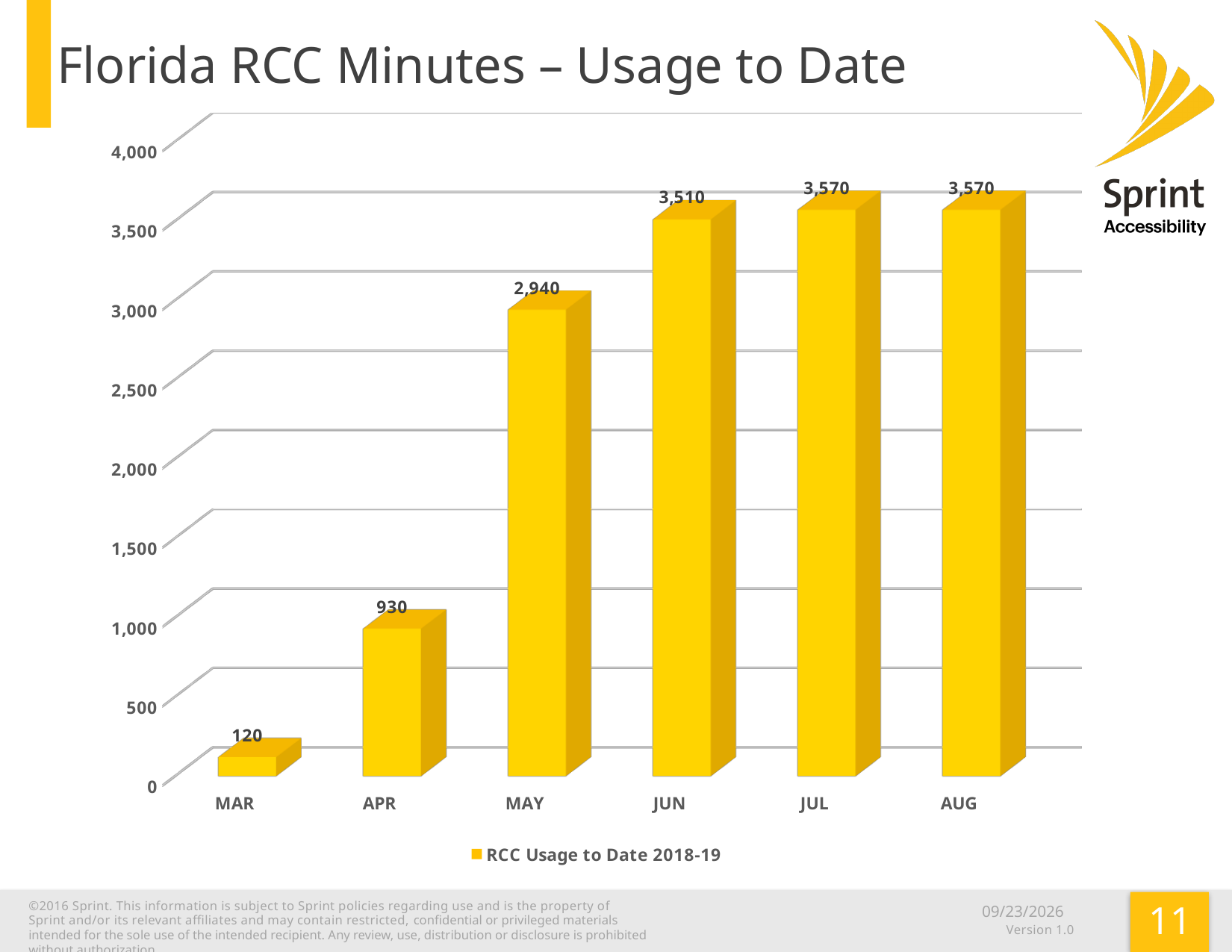
What is the RCC usage value for MAY? 2,940 What is the difference between the values for JUL and JUN? 60 Is the value for APR greater or less than 1,000? less Which is larger, the value for APR or the value for MAY? MAY How many series does the legend list? 1 What is the legend entry for the series shown? RCC Usage to Date 2018-19 Which month has the lowest RCC usage value? MAR What is the RCC usage value for JUN? 3,510 How many months are shown on the x axis? 6 What kind of chart is shown on the slide? bar chart What is the difference between the values for MAY and APR? 2,010 What is the RCC usage value for MAR? 120